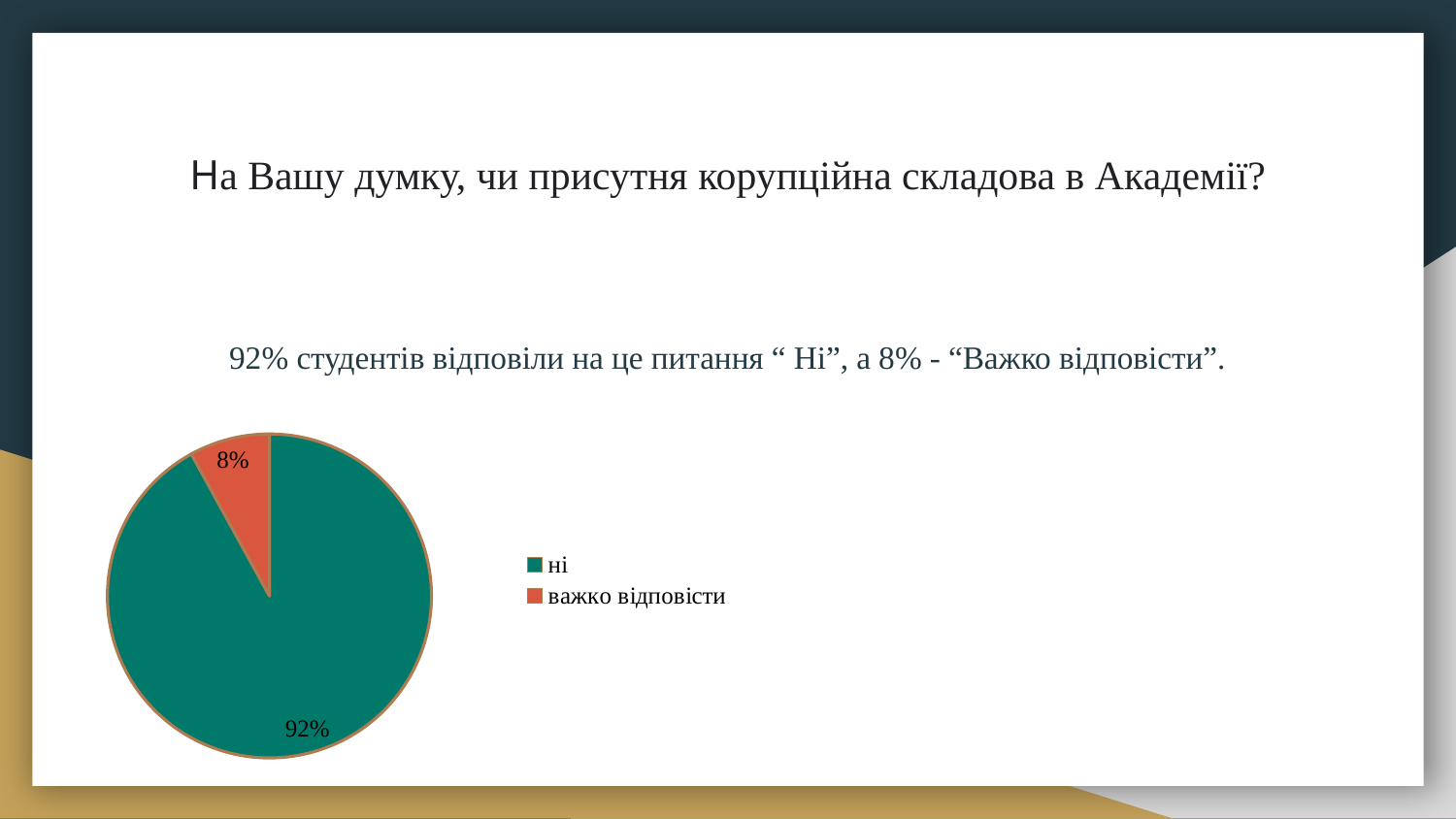
What colour is the "ні" slice in the pie chart? green How many slices does the pie chart have? 2 How many entries does the legend list? 2 What share of the pie does "важко відповісти" take? 8% What share of the pie does "ні" take? 92% Which slice of the pie is the smallest? важко відповісти What colour is the "важко відповісти" slice in the pie chart? orange Which slice of the pie is the largest? ні Which is larger: the "ні" slice or the "важко відповісти" slice? ні What is the difference in percentage points between the "ні" slice and the "важко відповісти" slice? 84 What kind of chart is shown on the slide? pie chart